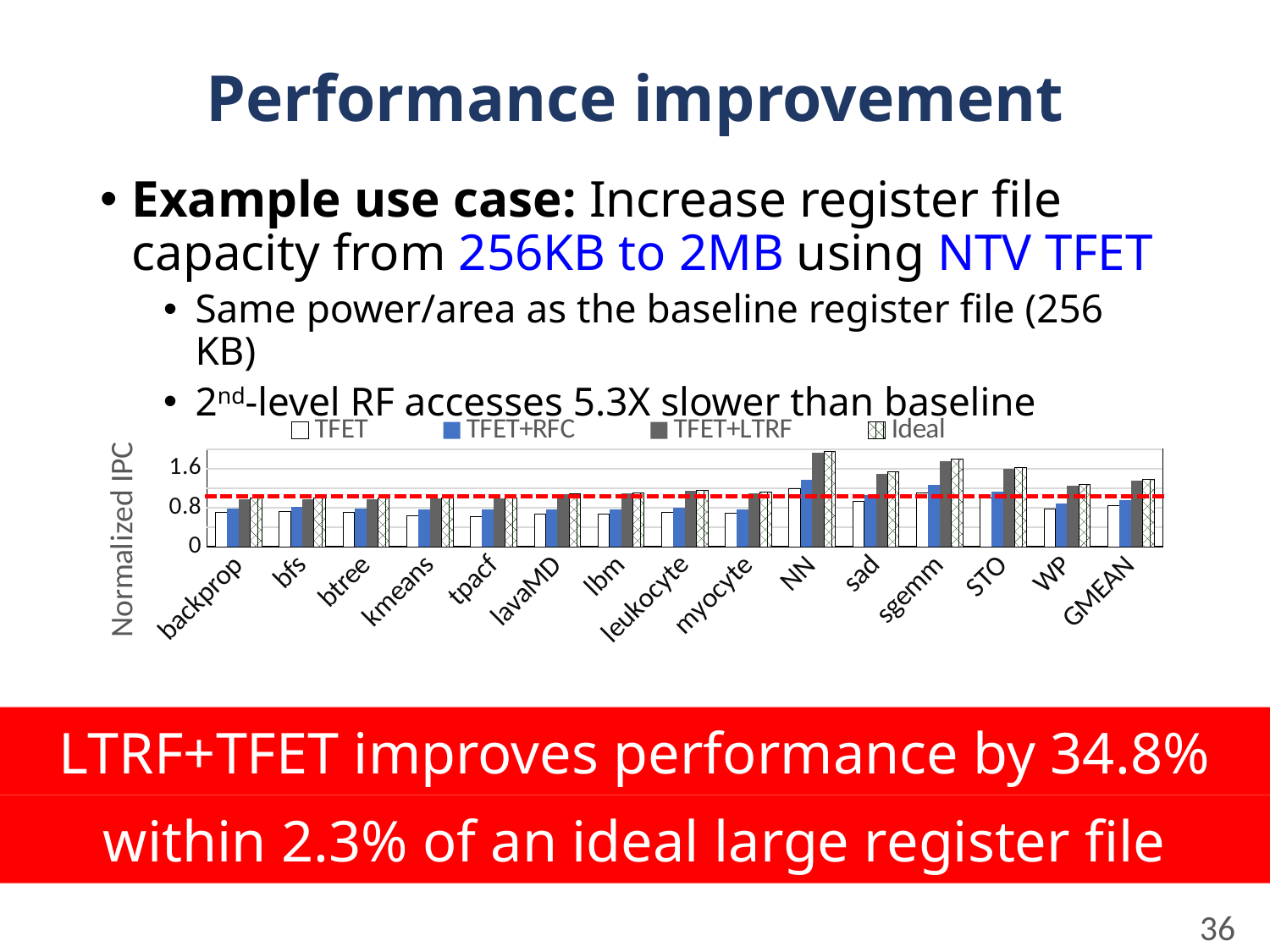
Is the TFET+RFC value for NN greater or less than 0.8? greater Which series are listed in the chart legend? TFET, TFET+RFC, TFET+LTRF, Ideal Which is larger, the Ideal value for NN or the Ideal value for bfs? NN Which category has the highest Ideal bar in the chart? NN Is the TFET value for backprop greater or less than 0.8? less What kind of chart is shown on the slide? bar chart Which is larger, the TFET+LTRF value for sgemm or the TFET+LTRF value for lbm? sgemm What is the label of the y axis of the chart? Normalized IPC Is the TFET+LTRF value for sgemm greater or less than 1.6? greater How many categories are shown along the x axis of the chart? 15 How many series does the chart legend list? 4